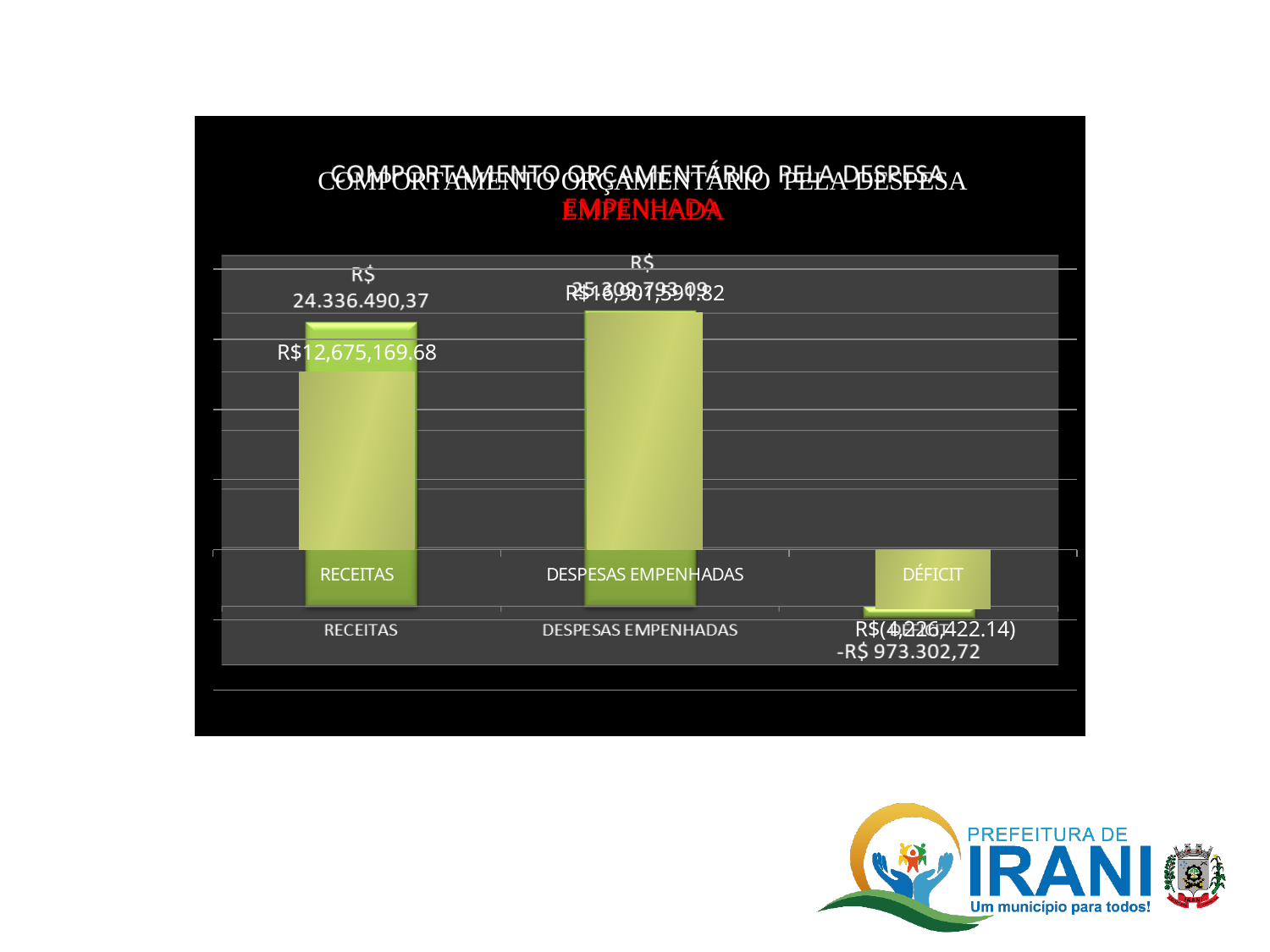
Which category has the tallest bar in the chart? DESPESAS EMPENHADAS What is the negative value printed in parentheses below the DÉFICIT bar? R$(4,226,422.14) What is the value printed with a leading minus sign below the DÉFICIT bar? -R$ 973.302,72 What kind of chart is shown on the slide? bar chart What is the title of the chart? COMPORTAMENTO ORÇAMENTÁRIO PELA DESPESA EMPENHADA Which category's bar extends below the horizontal axis? DÉFICIT Which category has the lowest value in the chart? DÉFICIT Which bar is taller, RECEITAS or DESPESAS EMPENHADAS? DESPESAS EMPENHADAS How many categories are shown on the x axis of the chart? 3 What is the uppermost data label printed above the RECEITAS bar? R$ 24.336.490,37